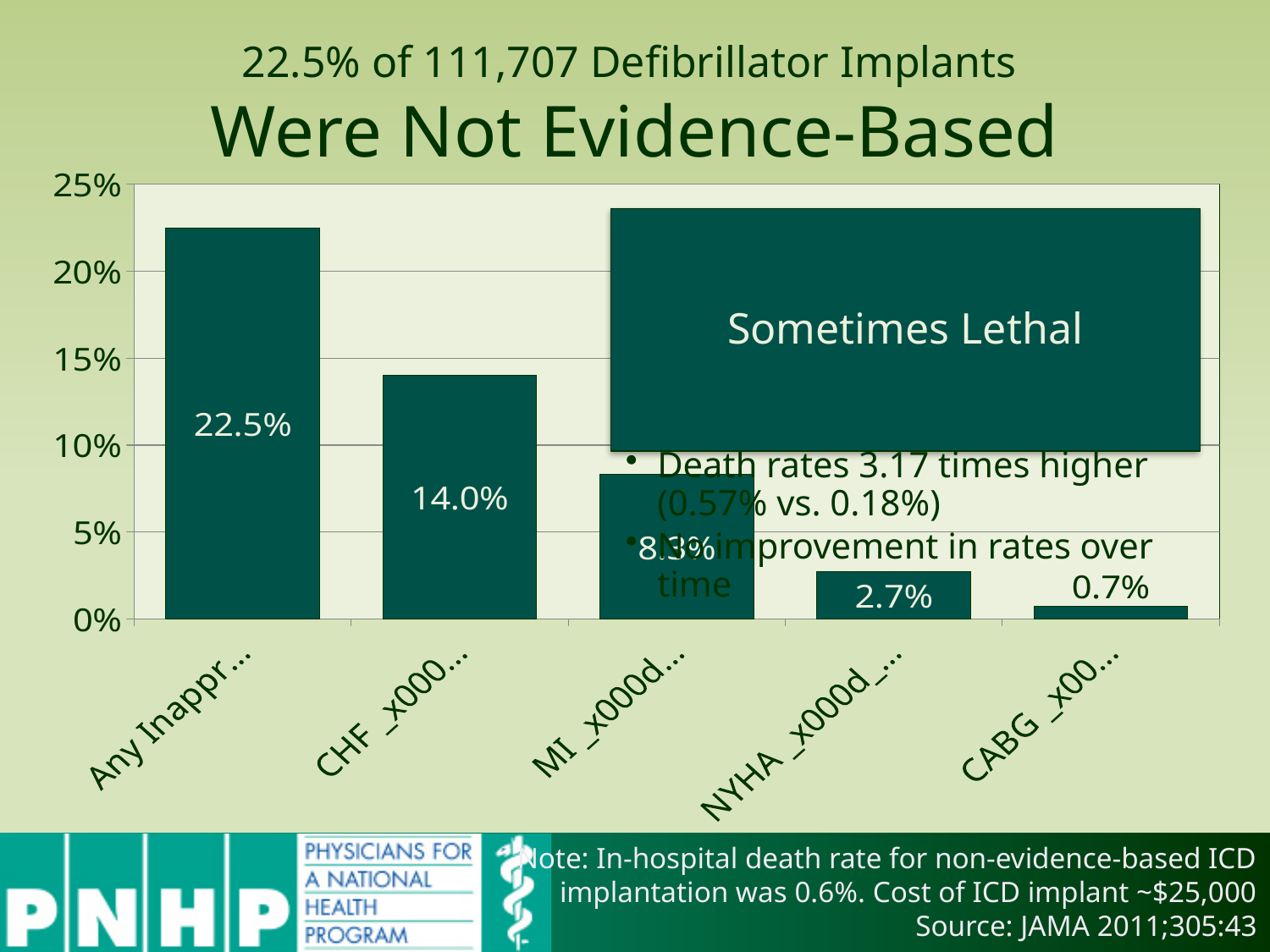
Do the bar values rise or fall from left to right across the chart? fall What kind of chart is shown on the slide? bar chart What is the value of the bar labelled "CABG"? 0.7% Is the value for the "MI" bar greater or less than 10%? less What is the value of the first bar, labelled "Any Inappr..."? 22.5% What is the difference between the "Any Inappr..." bar and the "CHF" bar? 8.5 percentage points What is the value of the bar labelled "CHF"? 14.0% Which category has the lowest value in the chart? CABG Which category has the highest value in the chart? Any Inappr... How many bars are plotted in the chart? 5 What is the value of the bar labelled "NYHA"? 2.7% Which is larger, the value for "NYHA" or the value for "CABG"? NYHA